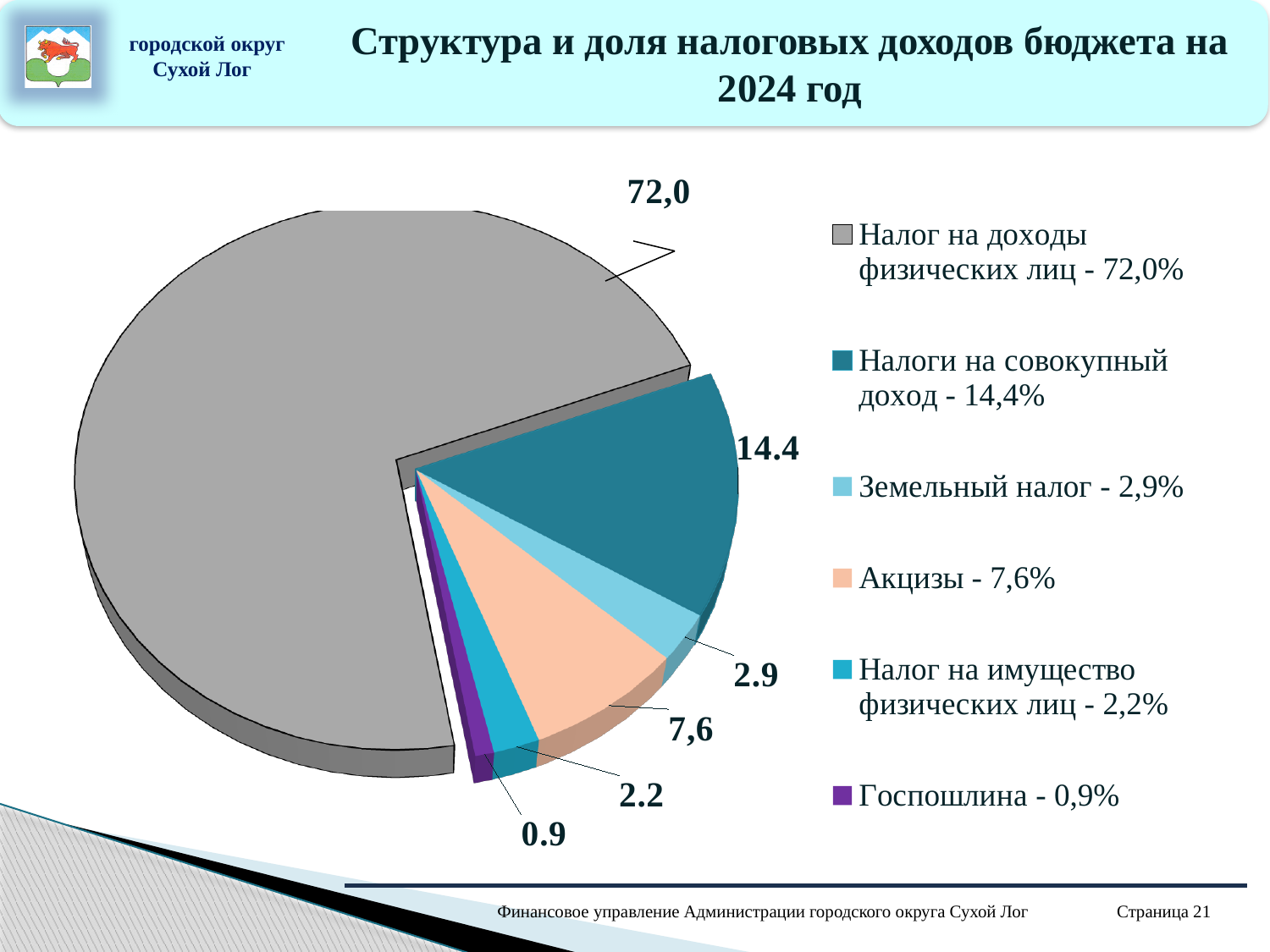
What value is labelled on the slice for Налоги на совокупный доход? 14.4 What is the share of Акцизы according to the legend? 7,6% Which category has the smallest slice of the pie? Госпошлина How many categories does the pie chart show? 6 What value is labelled on the slice for Госпошлина? 0.9 What is the share of Налог на доходы физических лиц in the pie chart? 72,0% What is the difference between the share of Налоги на совокупный доход and the share of Акцизы? 6,8% Which is larger, the share of Акцизы or the share of Земельный налог? Акцизы What is the share of Налог на имущество физических лиц? 2,2% What kind of chart is shown on the slide? pie chart Which category has the largest slice of the pie? Налог на доходы физических лиц What value is labelled on the slice for Земельный налог? 2.9